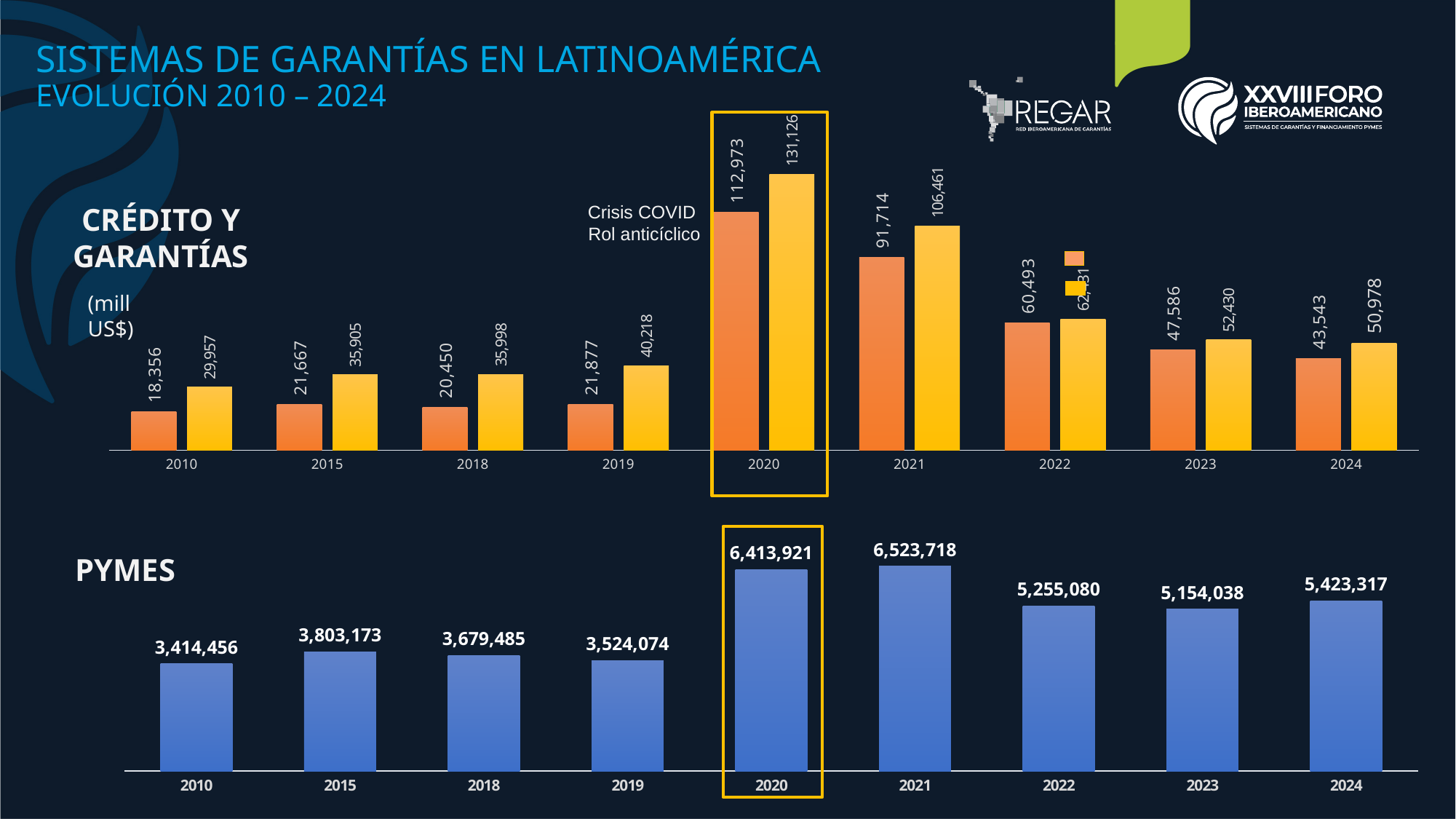
In the PYMES chart, what is the difference between the 2021 value and the 2020 value? 109,797 In the CRÉDITO Y GARANTÍAS chart, what unit is stated for the values? mill US$ In the PYMES chart, which year has the highest value? 2021 What type of chart is the PYMES chart? bar chart In the CRÉDITO Y GARANTÍAS chart, is the orange bar for 2019 larger or smaller than the orange bar for 2015? larger In the PYMES chart, which year has the lowest value? 2010 In the PYMES chart, what is the value for 2020? 6,413,921 In the CRÉDITO Y GARANTÍAS chart, what is the difference between the yellow bar and the orange bar for 2021? 14,747 In the CRÉDITO Y GARANTÍAS chart, what is the value of the yellow bar for 2020? 131,126 In the PYMES chart, how many years are shown on the x axis? 9 In the CRÉDITO Y GARANTÍAS chart, which year has the highest orange bar? 2020 In the CRÉDITO Y GARANTÍAS chart, what is the value of the orange bar for 2010? 18,356